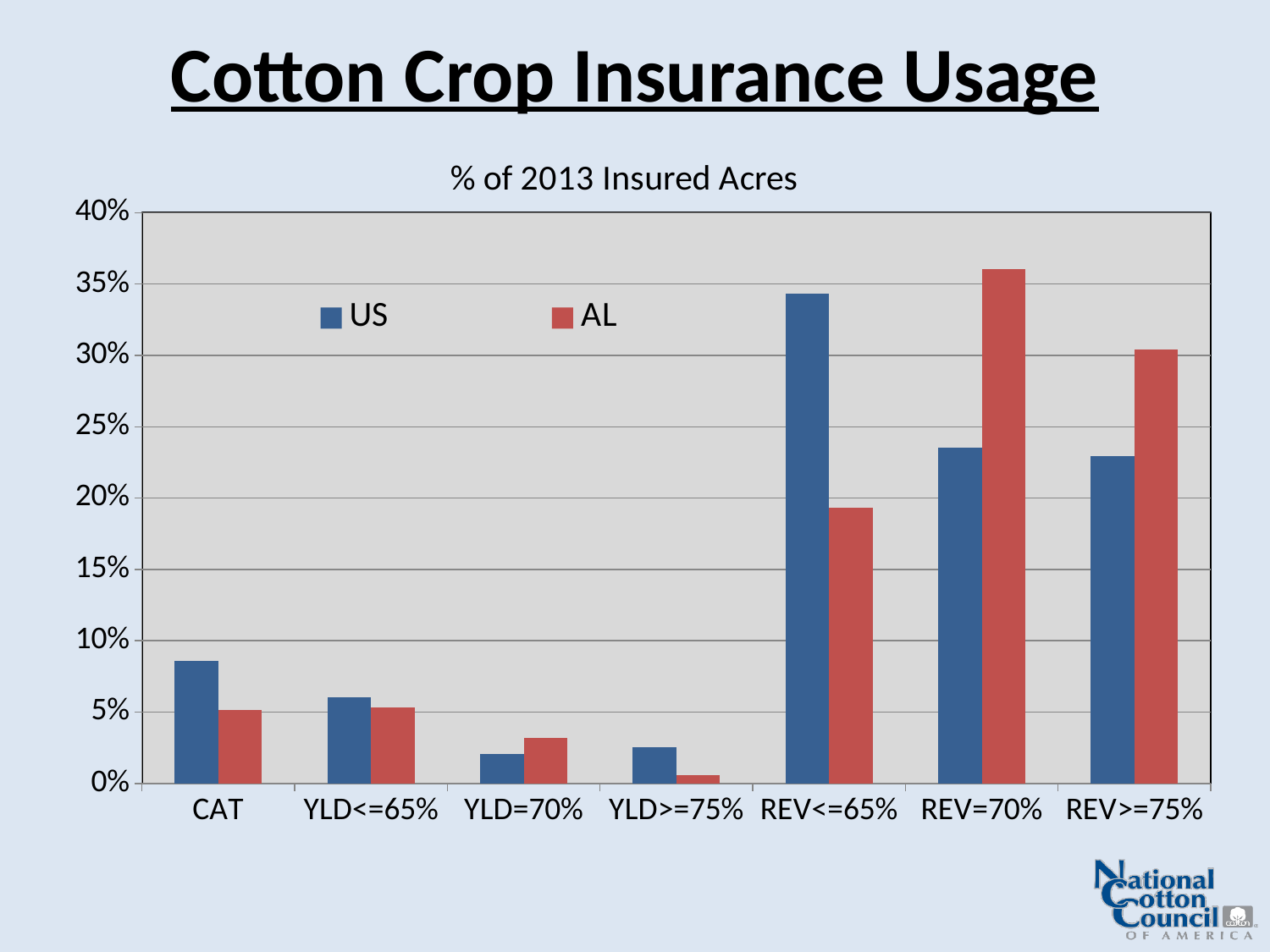
Is the AL value for REV<=65% greater or less than 20%? less What kind of chart is shown on the slide? bar chart How many series does the legend list? 2 Is the US value for REV<=65% greater or less than 30%? greater Which category has the highest AL value? REV=70% For REV=70%, which is larger, the US value or the AL value? AL For CAT, which is larger, the US value or the AL value? US Which category has the highest US value? REV<=65% Which category has the lowest AL value? YLD>=75% What is the subtitle shown above the chart? % of 2013 Insured Acres How many categories are shown on the x axis? 7 Which category has the lowest US value? YLD=70%